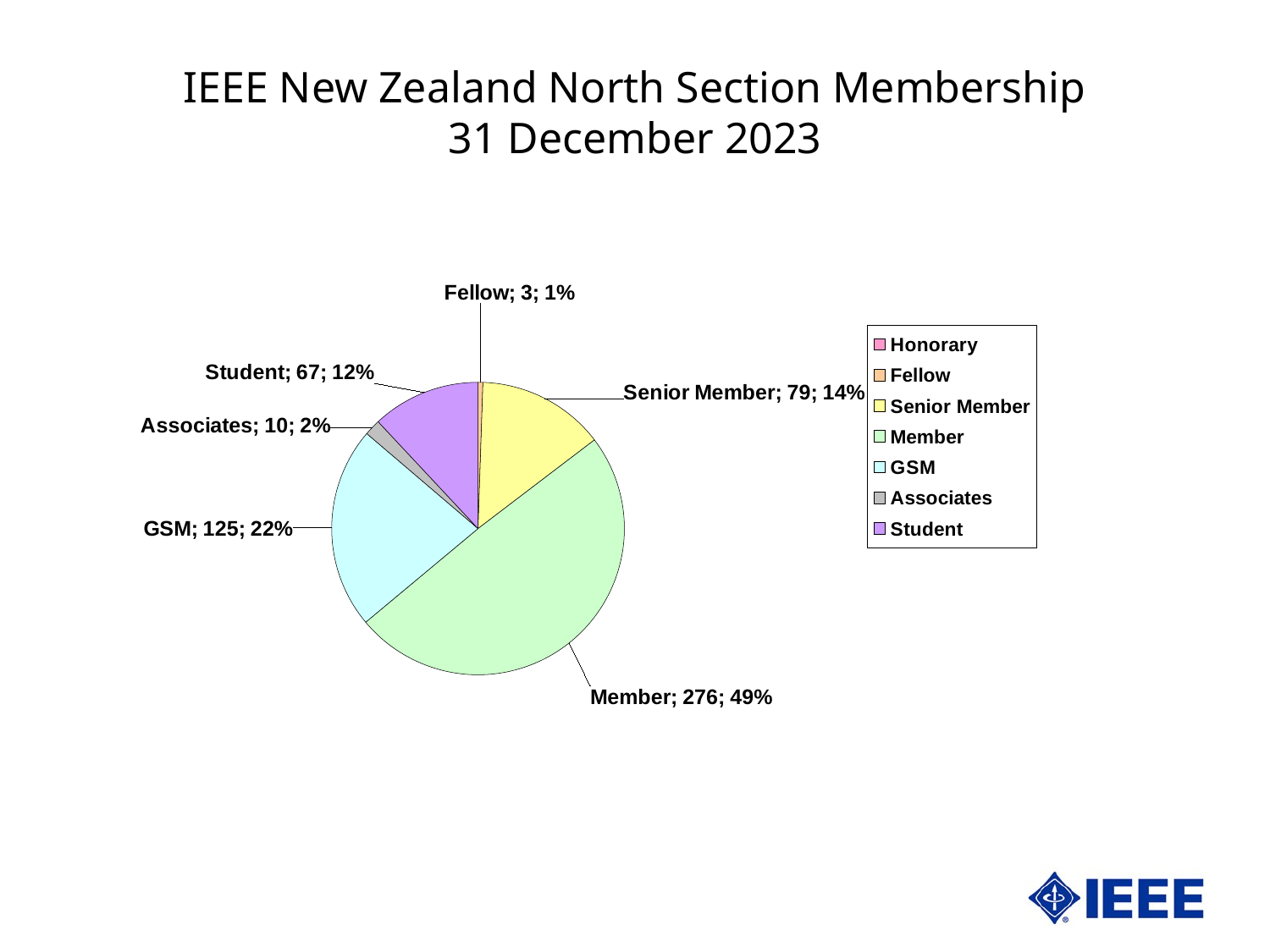
Which category has more members, Senior Member or Student? Senior Member Which category has the largest slice of the pie? Member What type of chart is shown on the slide? pie chart How many members are in the Member category? 276 What is the difference between the number of GSM members and the number of Student members? 58 What share of the pie does the Student category represent? 12% How many members are in the Senior Member category? 79 Which labelled category has the smallest slice of the pie? Fellow What is the title of the slide containing the chart? IEEE New Zealand North Section Membership 31 December 2023 How many members are in the Associates category? 10 How many entries does the legend list? 7 What percentage of the membership is GSM? 22%